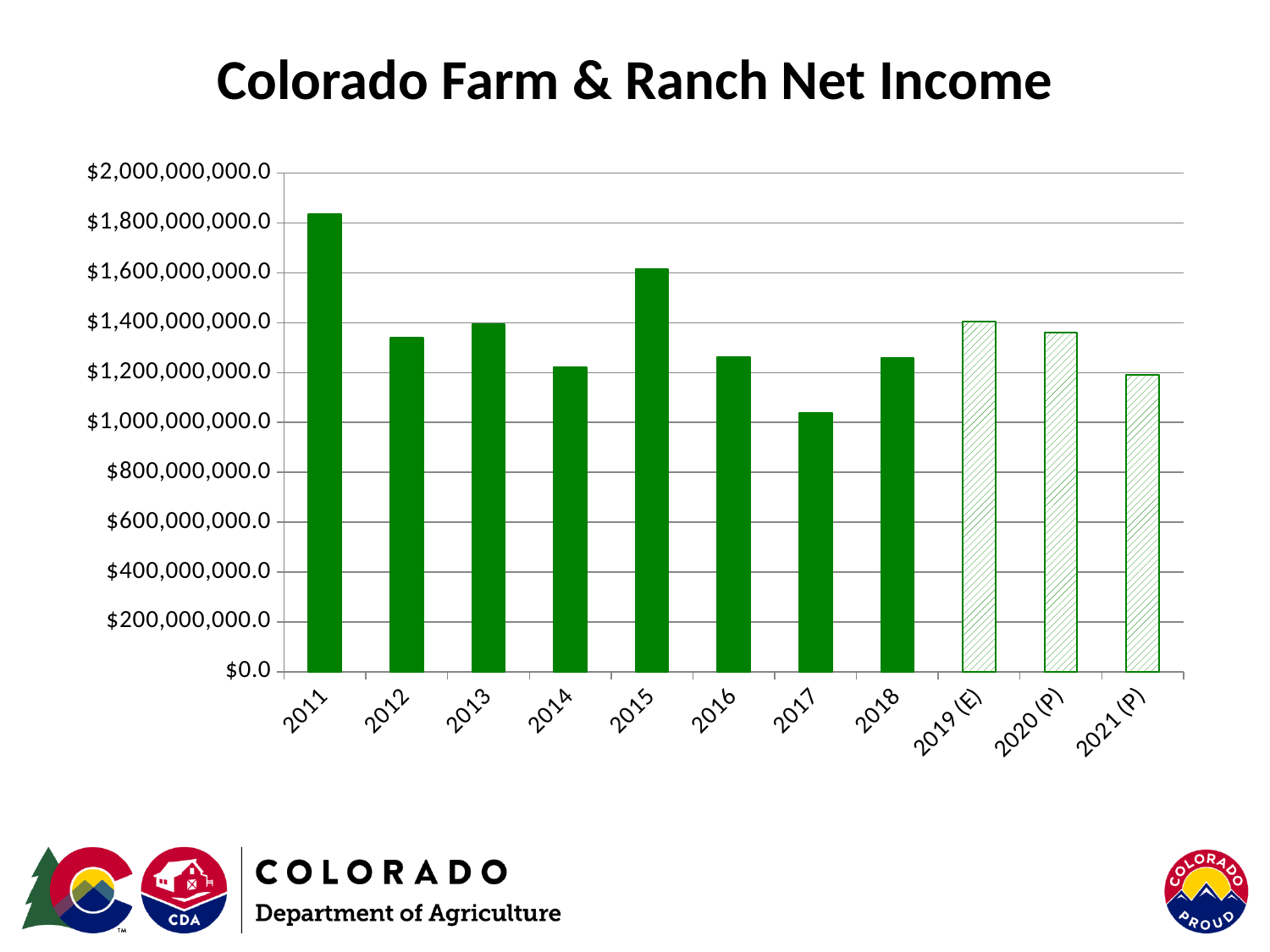
Which is larger, the value for 2014 or the value for 2017? 2014 How many years (categories) are shown on the x axis of the chart? 11 Do the values rise or fall from 2019 (E) to 2021 (P)? fall Which year has the lowest net income in the chart? 2017 Is the value for 2015 greater or less than $1,400,000,000.0? greater Which is larger, the value for 2011 or the value for 2015? 2011 What is the title of the chart? Colorado Farm & Ranch Net Income Is the value for 2014 greater or less than $1,400,000,000.0? less What kind of chart is shown on the slide? bar chart Which year has the highest net income in the chart? 2011 Is the value for 2011 greater or less than $1,600,000,000.0? greater